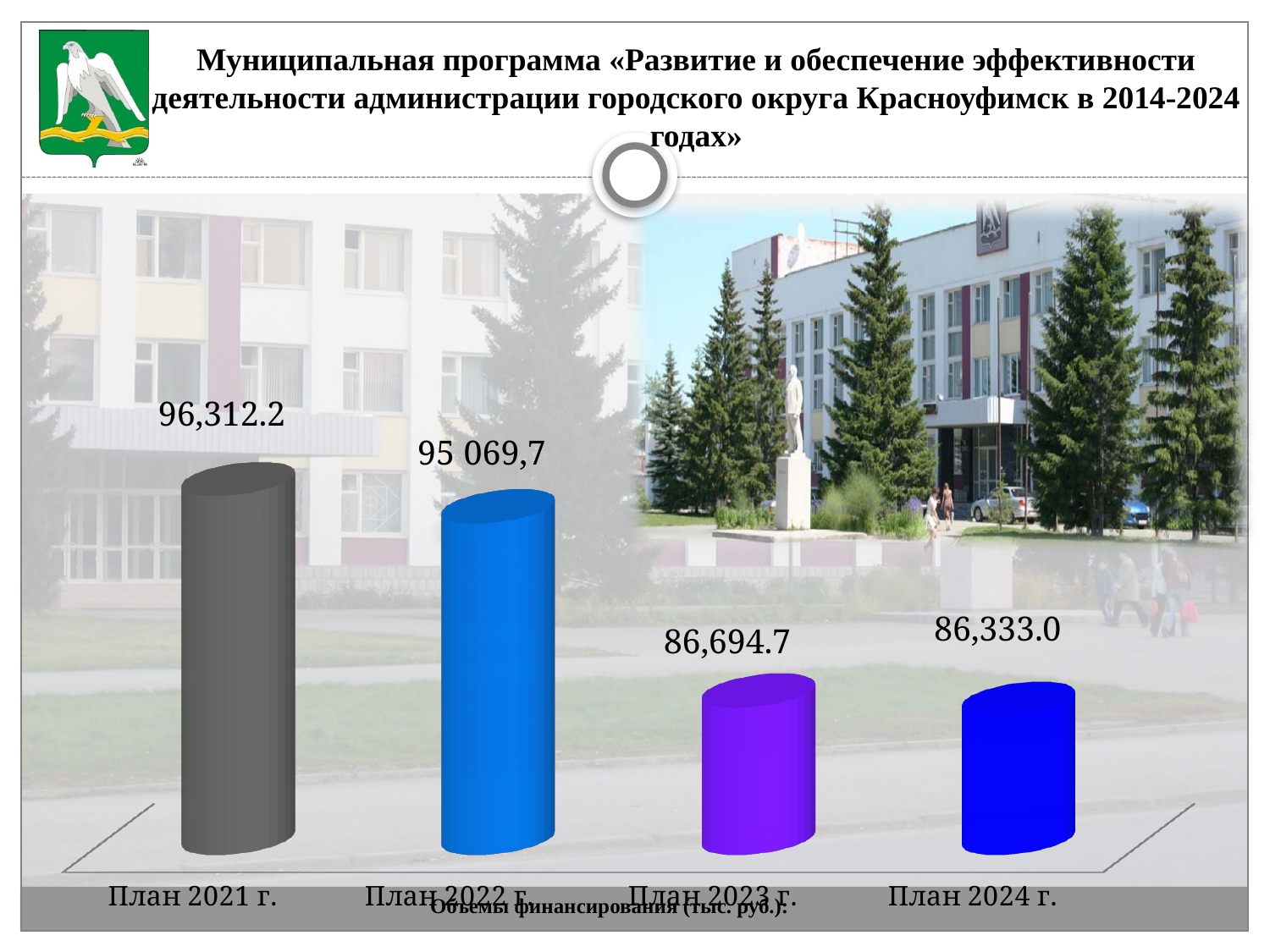
What is the value for План 2021 г.? 96,312.2 What is the value for План 2024 г.? 86,333.0 Which is larger, the value for План 2021 г. or План 2022 г.? План 2021 г. Which category has the lowest value? План 2024 г. What is the difference between the values for План 2021 г. and План 2024 г.? 9,979.2 What is the value for План 2023 г.? 86,694.7 Which category has the highest value? План 2021 г. What kind of chart is shown on the slide? Bar chart What is the value for План 2022 г.? 95 069,7 Do the values rise or fall from План 2021 г. to План 2024 г.? Fall What is the difference between the values for План 2023 г. and План 2024 г.? 361.7 How many categories are shown in the chart? 4